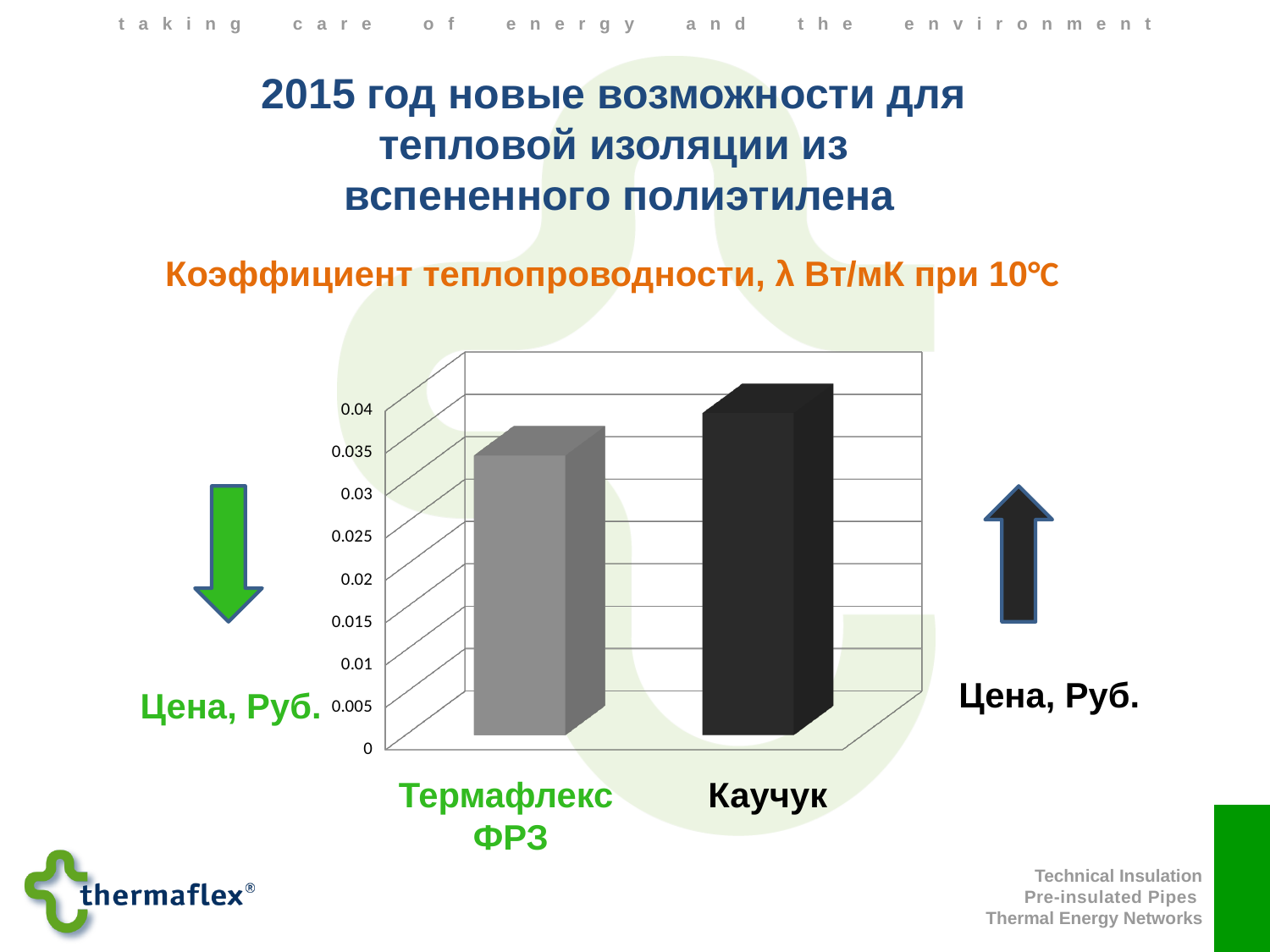
Which category has the lowest value in the chart? Термафлекс ФРЗ Is the value for Каучук greater or less than 0.02? greater Is the value for Термафлекс ФРЗ greater or less than 0.04? less Which category has the highest value in the chart? Каучук Which has the larger value, Термафлекс ФРЗ or Каучук? Каучук What kind of chart is shown on the slide? bar chart Is the value for Термафлекс ФРЗ greater or less than 0.02? greater What colour is the bar for Каучук? black How many categories are plotted in the chart? 2 What is the title shown above the chart? Коэффициент теплопроводности, λ Вт/мК при 10℃